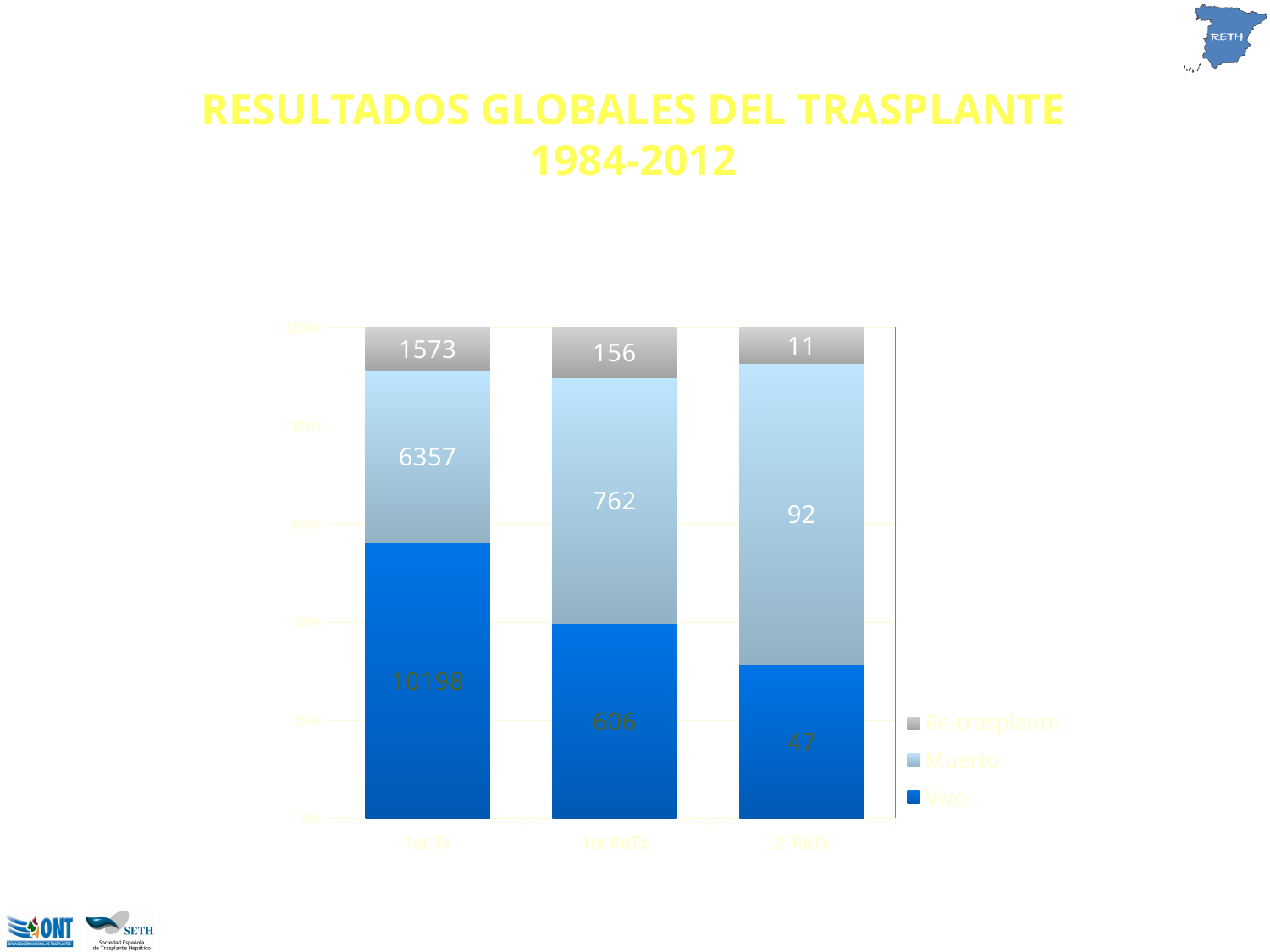
What is the total of the three values in the 2º ReTx bar? 150 What is the Re-trasplante value for 2º ReTx? 11 What is the Muerto value for 1er ReTx? 762 How many series does the legend list? 3 What is the Vivo value for 1er Tx? 10198 How many categories are shown on the x axis? 3 Which category has the highest Vivo value? 1er Tx What is the Re-trasplante value for 1er Tx? 1573 What kind of chart is shown on the slide? Stacked bar chart Which category has the lowest Muerto value? 2º ReTx Which is larger for 2º ReTx, the Vivo value or the Muerto value? Muerto What is the difference between the Muerto and Vivo values for 1er ReTx? 156